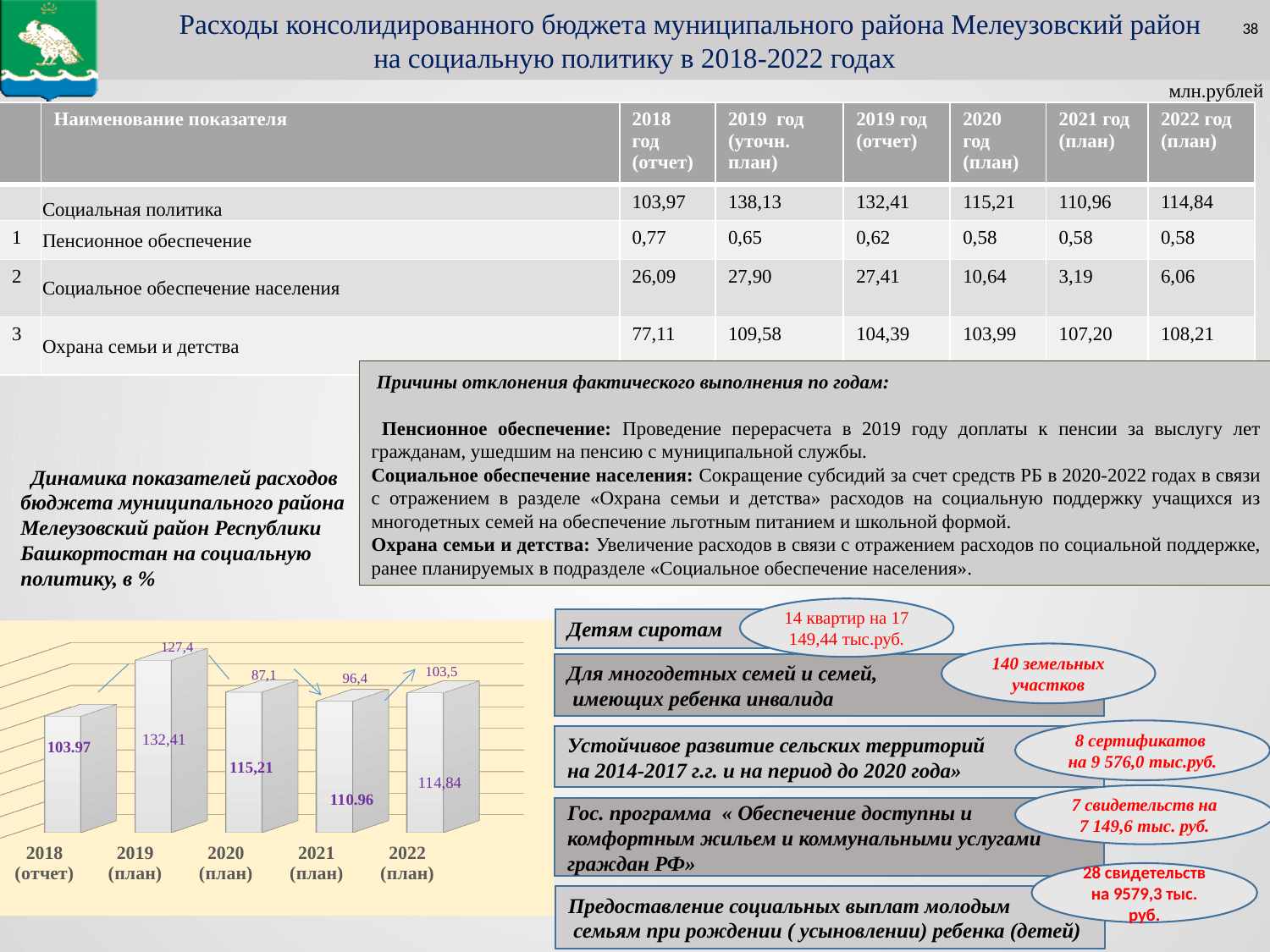
What is the difference between the values for 2019 (план) and 2020 (план) in the bar chart? 17,20 Which year has the lowest bar in the chart? 2018 (отчет) What is the value shown for 2021 (план) in the bar chart? 110.96 What is the difference between the values for 2020 (план) and 2022 (план) in the bar chart? 0,37 What is the value shown for 2022 (план) in the bar chart? 114,84 How many years (bars) are shown in the bar chart? 5 Which year has the highest bar in the chart? 2019 (план) Which is larger in the bar chart, the value for 2021 (план) or 2022 (план)? 2022 (план) What is the value shown for 2018 (отчет) in the bar chart? 103.97 What is the value shown for 2019 (план) in the bar chart? 132,41 Do the bar values rise or fall from 2019 (план) to 2021 (план)? fall What kind of chart is shown at the bottom left of the slide? bar chart